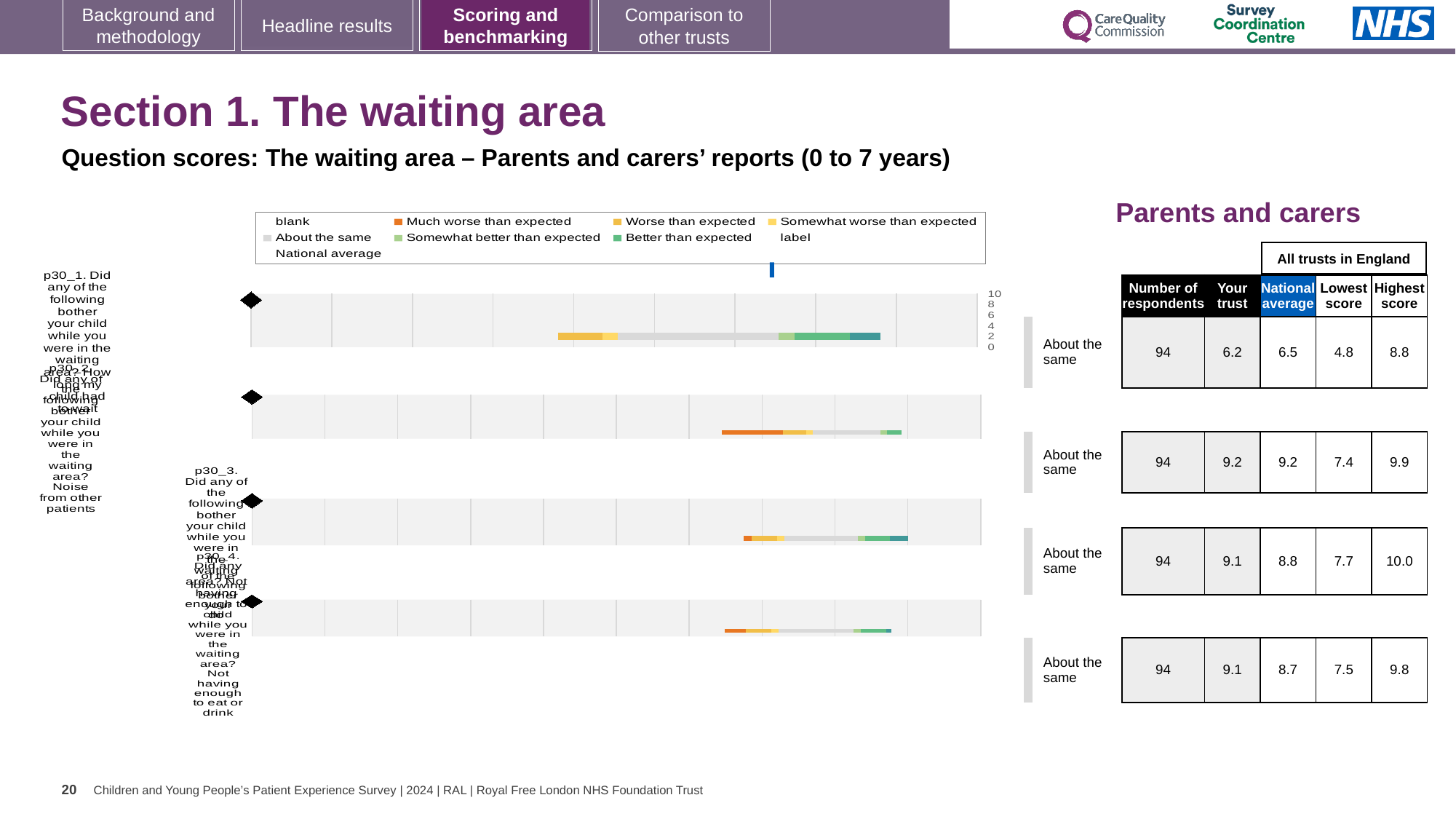
How many benchmarking bar charts are shown on the slide? 4 In the chart legend, which colour represents 'Much worse than expected'? orange In the table beside the charts, what is the national average in the first row? 6.5 According to the labels beside the charts, how is the trust rated for each of the four questions? About the same In the table beside the charts, which row has the lowest 'Your trust' score? the first row (6.2) In the table beside the charts, what is the 'Your trust' score in the first row? 6.2 In the table beside the charts, how many respondents are listed for each question? 94 What kind of chart is used to show the question scores on this slide? bar chart In the table beside the charts, which row has the highest 'Your trust' score? the second row (9.2) What is the title of the table to the right of the charts? Parents and carers In the table beside the charts, is the 'Your trust' score in the third row larger or smaller than the national average in that row? larger In the table beside the charts, what is the difference between the highest score and the lowest score in the first row? 4.0